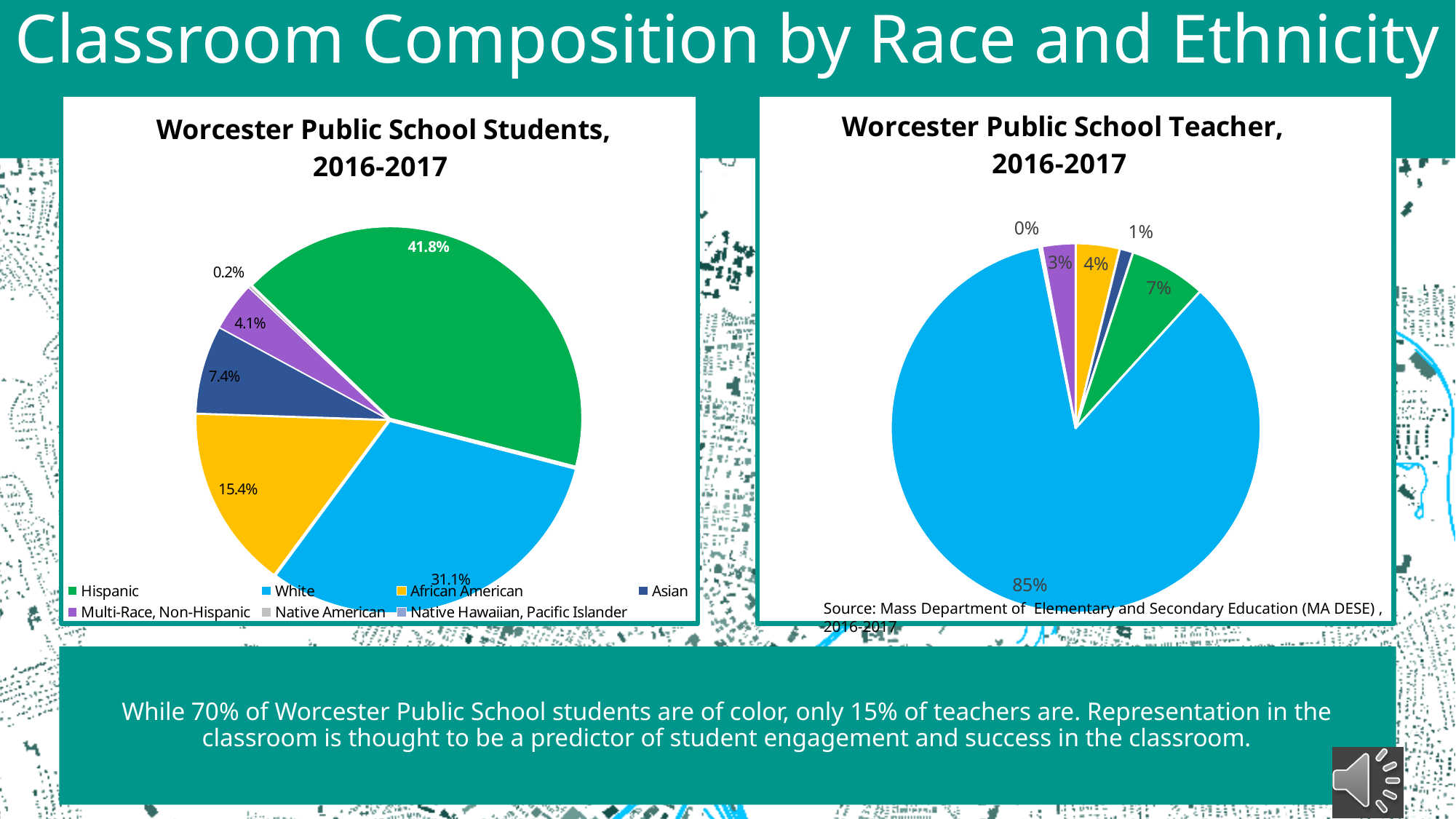
What type of chart is used on the slide for Worcester Public School Students, 2016-2017? pie chart In the Worcester Public School Students, 2016-2017 chart, what is the difference between the Hispanic and White shares? 10.7% How many categories does the legend of the Worcester Public School Students, 2016-2017 chart list? 7 In the Worcester Public School Students, 2016-2017 chart, what percentage of students are White? 31.1% In the Worcester Public School Students, 2016-2017 chart, what percentage of students are Hispanic? 41.8% In the Worcester Public School Students, 2016-2017 chart, which is larger, the African American share or the Asian share? African American In the Worcester Public School Students, 2016-2017 chart, what colour represents the Multi-Race, Non-Hispanic category? purple In the Worcester Public School Teacher, 2016-2017 chart, what is the value of the green slice? 7% In the Worcester Public School Students, 2016-2017 chart, what percentage of students are Asian? 7.4% In the Worcester Public School Students, 2016-2017 chart, what percentage of students are African American? 15.4% In the Worcester Public School Teacher, 2016-2017 chart, what is the value of the largest slice? 85% In the Worcester Public School Students, 2016-2017 chart, which group has the largest share? Hispanic